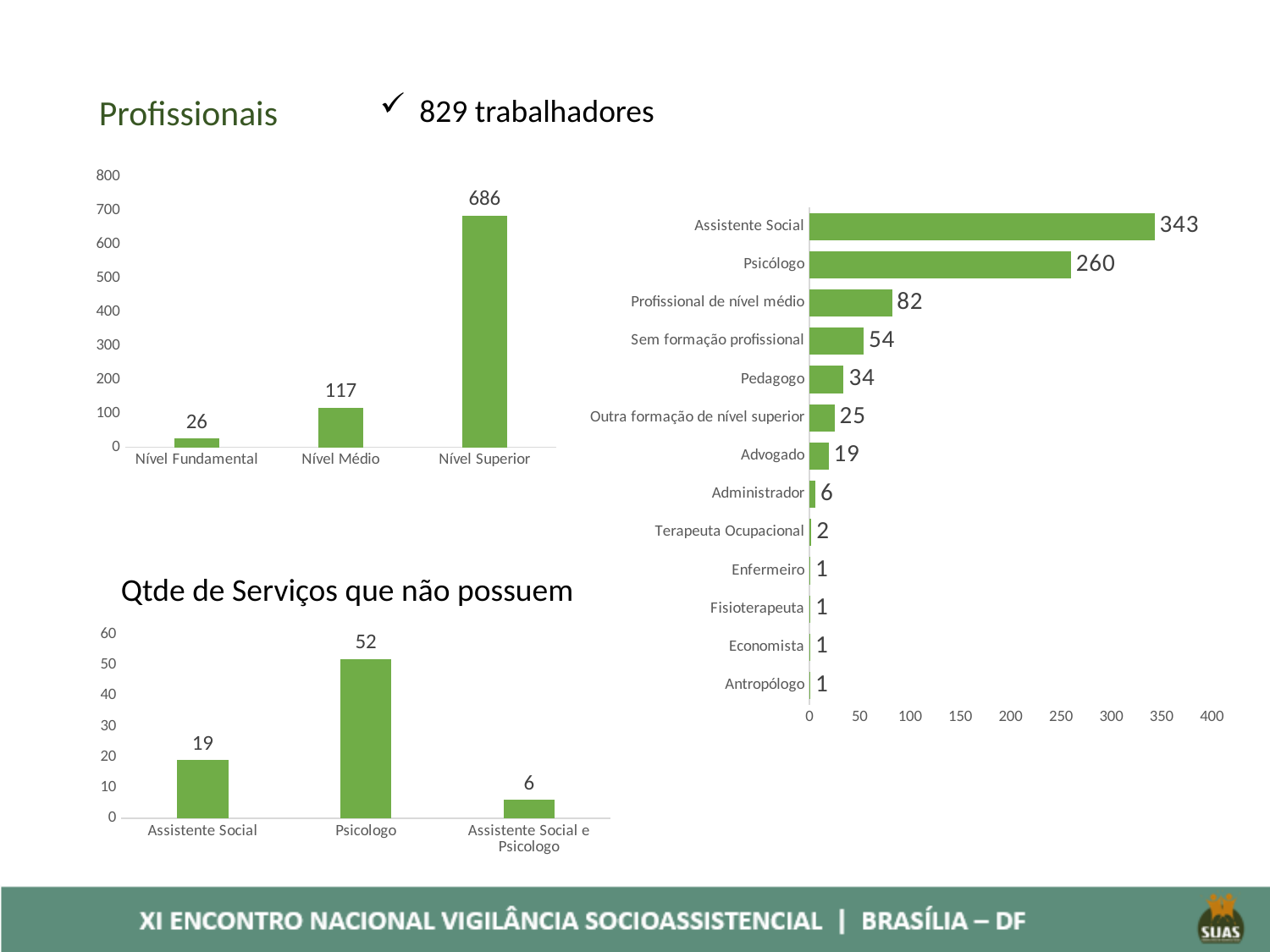
In the chart on the right, which is larger: Pedagogo or Advogado? Pedagogo In the chart titled 'Qtde de Serviços que não possuem', what is the value for Psicologo? 52 In the chart on the right, which category has the highest value? Assistente Social In the chart titled 'Qtde de Serviços que não possuem', what is the total of the three values shown? 77 How many categories does the top-left chart show? 3 How many categories does the chart on the right show? 13 In the chart on the right, what is the difference between Assistente Social and Psicólogo? 83 In the top-left chart, which category has the lowest value? Nível Fundamental In the top-left chart, what is the value for Nível Superior? 686 In the chart on the right, what is the value for Psicólogo? 260 In the top-left chart, what is the difference between Nível Superior and Nível Médio? 569 What type of chart is the chart on the right? Bar chart